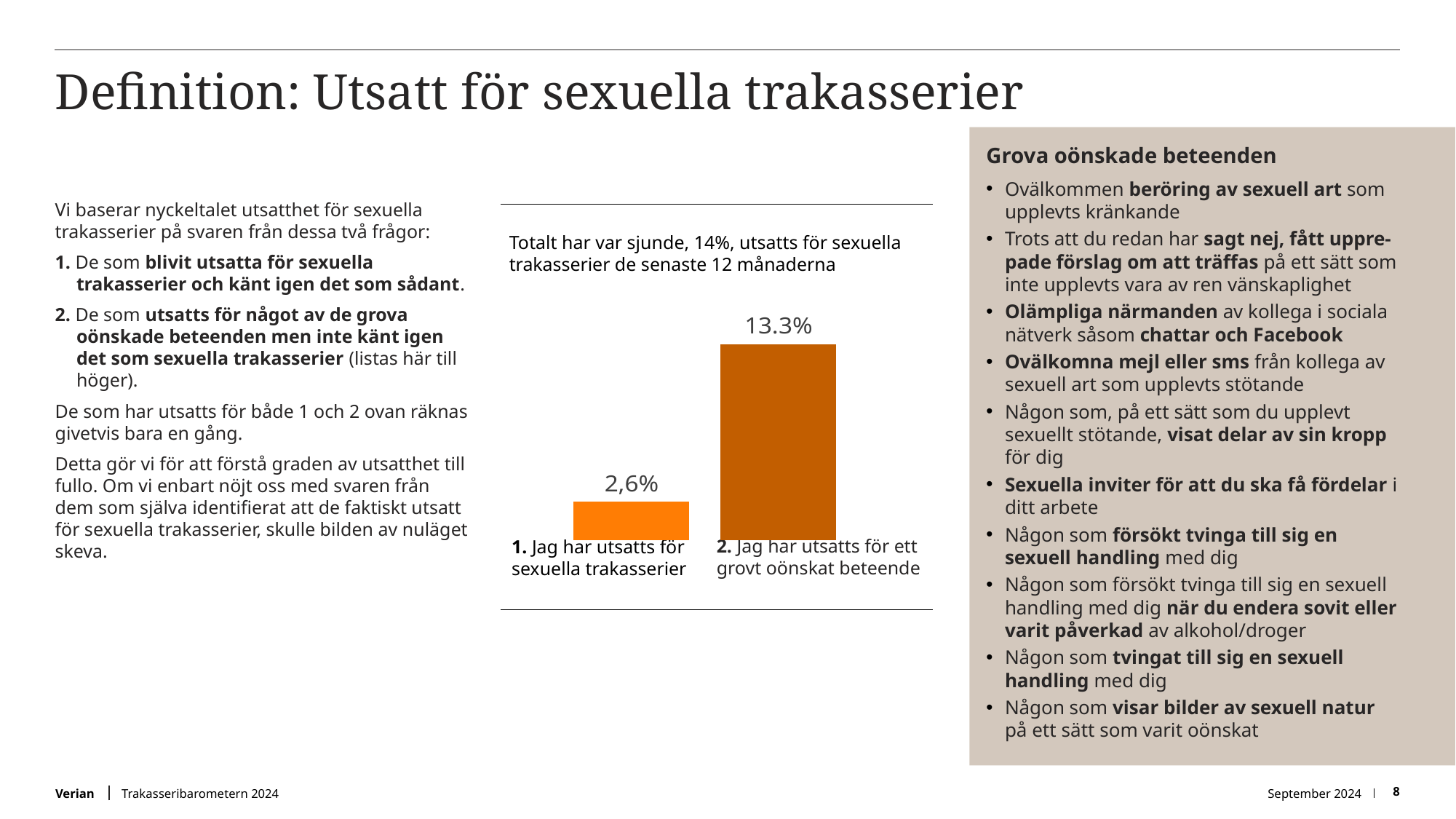
What is the title text above the chart? Totalt har var sjunde, 14%, utsatts för sexuella trakasserier de senaste 12 månaderna Which category has the highest value in the chart? 2. Jag har utsatts för ett grovt oönskat beteende How many bars are plotted in the chart? 2 What kind of chart is shown on the slide? Bar chart What colour are the bars in the chart? Orange Which is larger: the value for '1. Jag har utsatts för sexuella trakasserier' or for '2. Jag har utsatts för ett grovt oönskat beteende'? 2. Jag har utsatts för ett grovt oönskat beteende What is the value shown for the bar '1. Jag har utsatts för sexuella trakasserier'? 2,6% Do the bar values rise or fall from left to right in the chart? Rise Which category has the lowest value in the chart? 1. Jag har utsatts för sexuella trakasserier What is the value shown for the bar '2. Jag har utsatts för ett grovt oönskat beteende'? 13.3% What is the difference between the values of the two bars in the chart? 10.7%